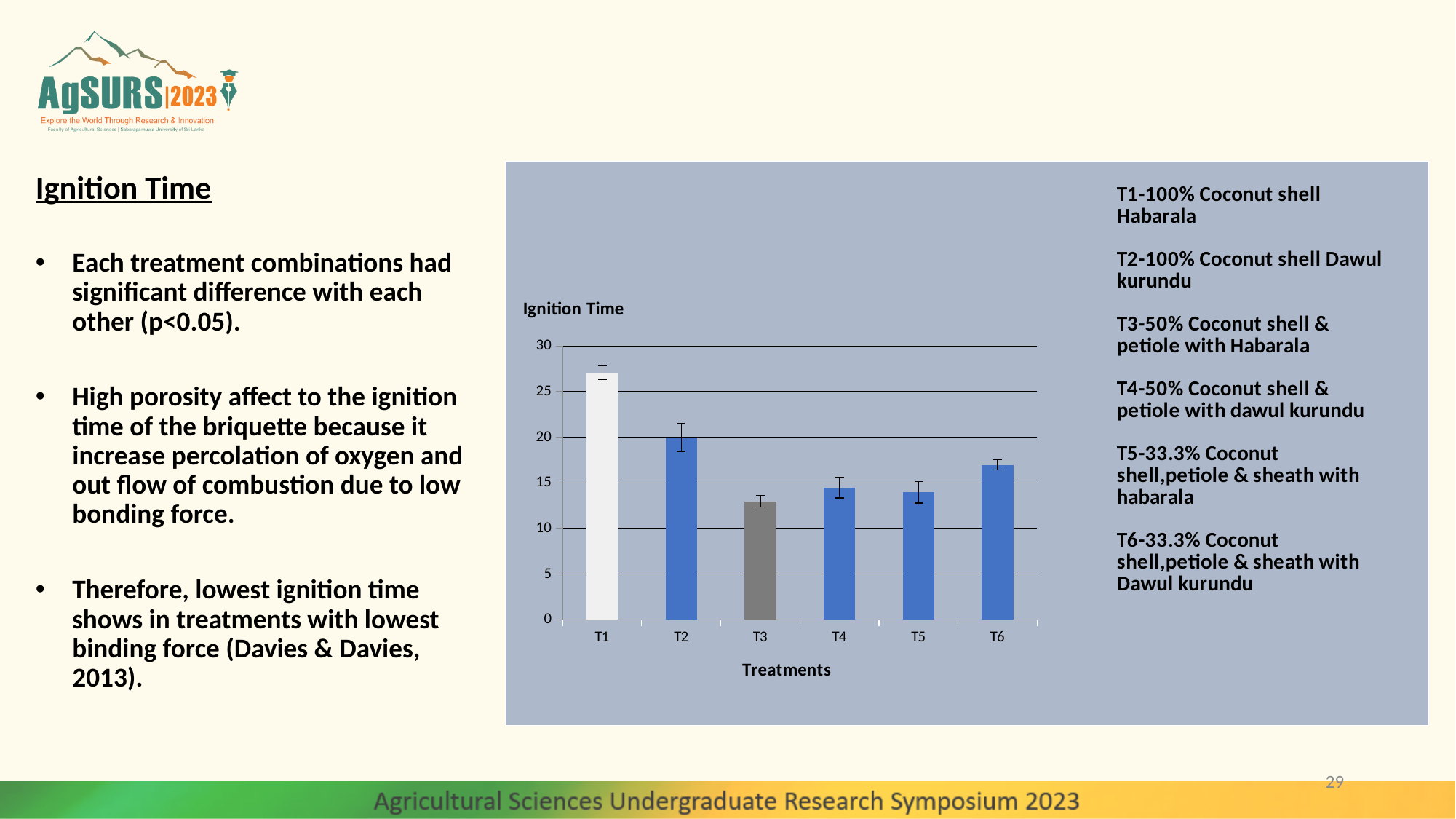
Is the ignition time for T6 greater or less than 20? less How many treatments are plotted on the x axis of the chart? 6 Which treatment has the highest ignition time in the chart? T1 Which has the higher ignition time, T2 or T6? T2 Is the ignition time for T3 greater or less than 10? greater What is the title of the chart? Ignition Time What kind of chart is shown on the slide? bar chart Is the ignition time for T2 greater or less than 25? less Which treatment has the lowest ignition time in the chart? T3 Which has the higher ignition time, T1 or T2? T1 What is the label of the x axis of the chart? Treatments